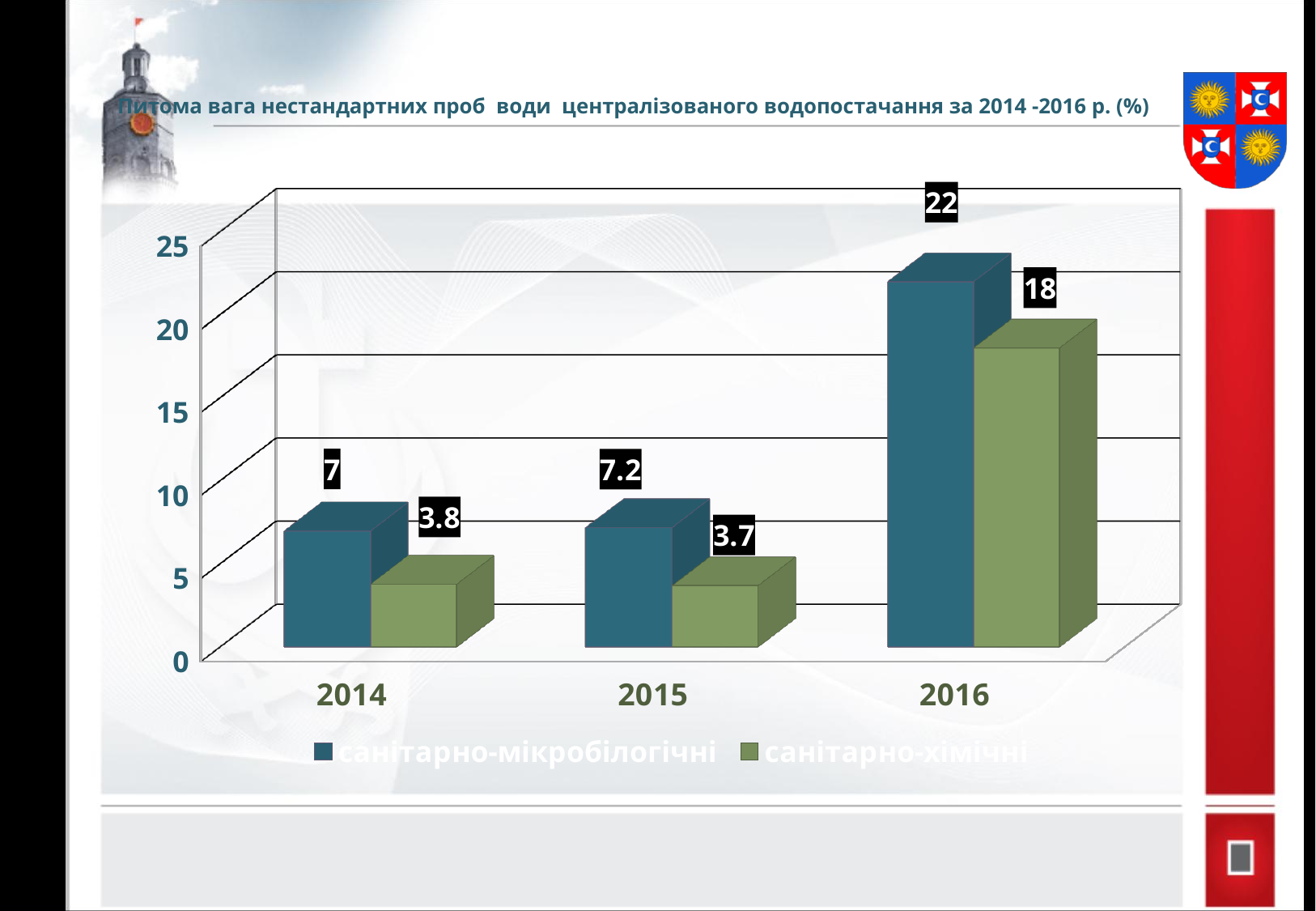
What is the value for санітарно-мікробілогічні in 2016? 22 What kind of chart is shown on the slide? bar chart What is the difference between санітарно-мікробілогічні and санітарно-хімічні in 2016? 4 What is the value for санітарно-мікробілогічні in 2015? 7.2 Does the value for санітарно-мікробілогічні rise or fall from 2014 to 2016? rise Which is larger in 2014: санітарно-мікробілогічні or санітарно-хімічні? санітарно-мікробілогічні In which year is the value for санітарно-мікробілогічні the highest? 2016 How many years are shown on the x axis? 3 What is the value for санітарно-хімічні in 2016? 18 In which year is the value for санітарно-хімічні the lowest? 2015 What is the value for санітарно-хімічні in 2014? 3.8 How many series does the legend list? 2